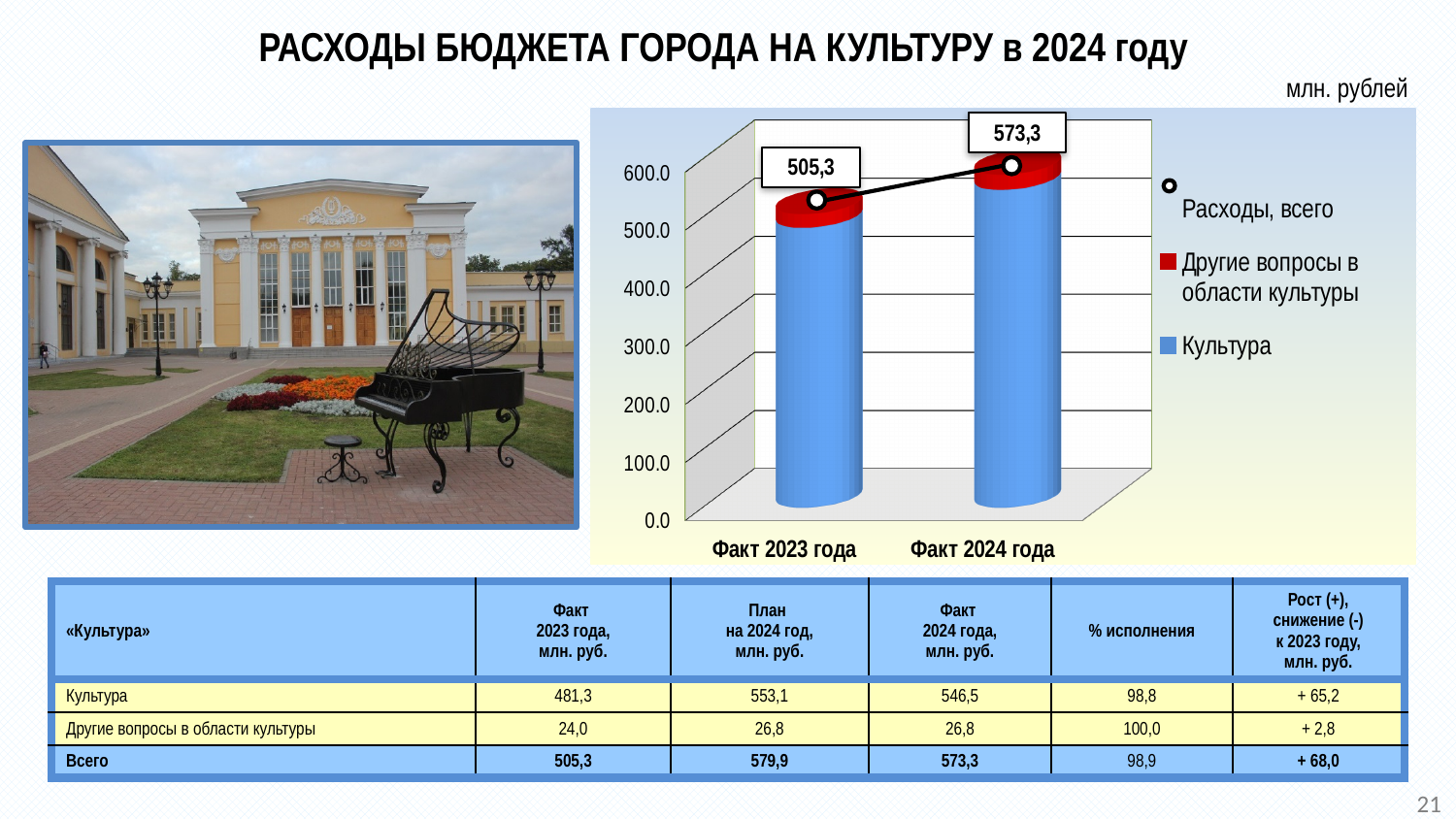
What is the value of the "Расходы, всего" series for Факт 2024 года? 573,3 By how much does "Расходы, всего" for Факт 2024 года exceed that for Факт 2023 года? 68,0 What unit is indicated for the chart values? млн. рублей What is the value of the "Расходы, всего" series for Факт 2023 года? 505,3 How many categories are shown on the x axis of the chart? 2 How many series does the chart legend list? 3 Does the "Расходы, всего" line rise or fall from Факт 2023 года to Факт 2024 года? rise What kind of chart is shown on the slide? stacked bar chart with a line Which colour represents the "Культура" series in the chart? blue Which category has the higher total expenditure ("Расходы, всего"), Факт 2023 года or Факт 2024 года? Факт 2024 года Is the "Культура" segment for Факт 2023 года greater or less than 400.0? greater Is the "Культура" segment for Факт 2024 года greater or less than 500.0? greater